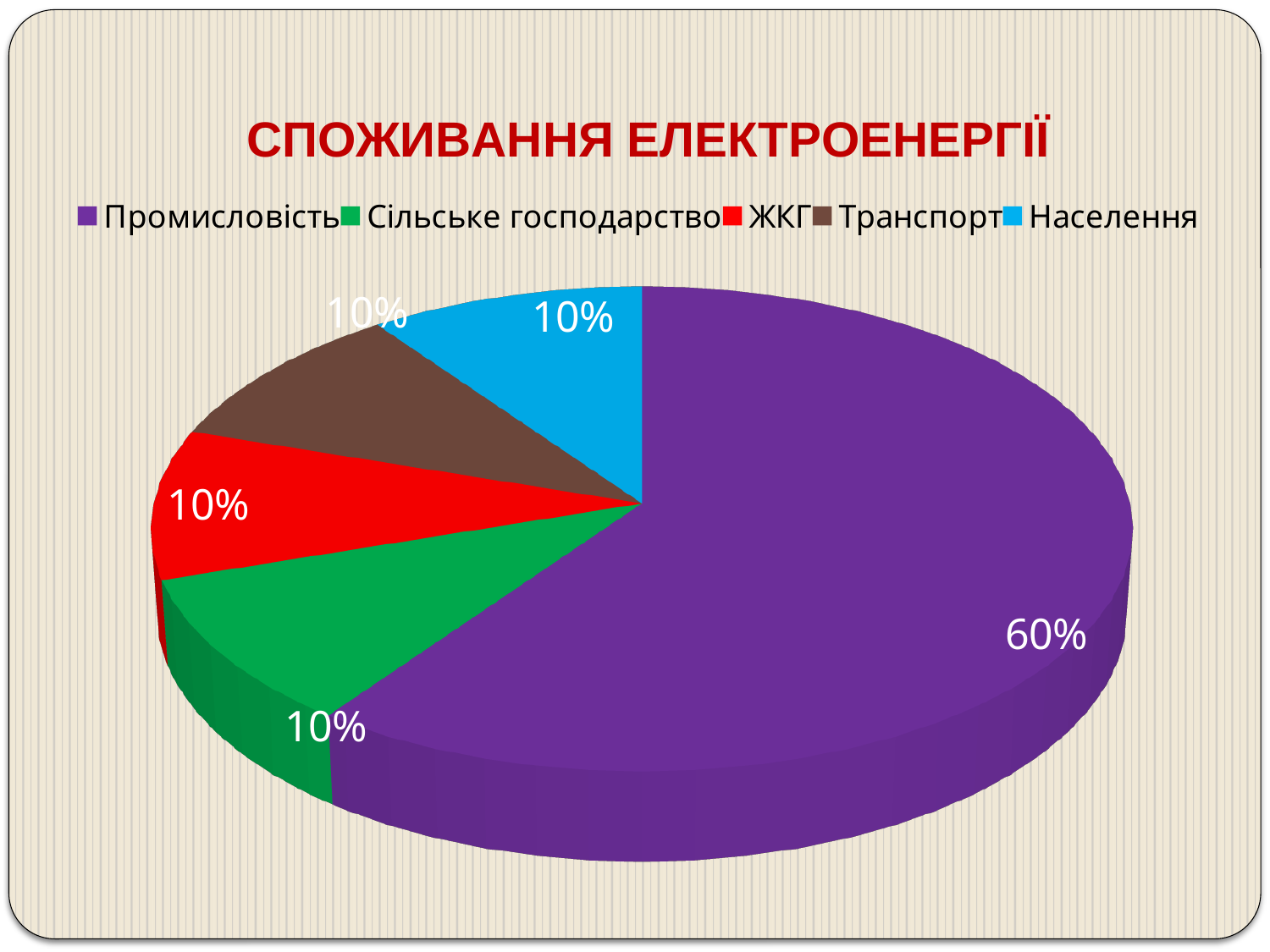
What colour is the slice for Населення? blue Which category has the largest slice of the pie? Промисловість What share of the pie does Населення have? 10% What is the difference between the shares of Промисловість and Транспорт? 50% How many categories does the legend list? 5 What share of the pie does Сільське господарство have? 10% What share of the pie does Транспорт have? 10% What share of the pie does ЖКГ have? 10% What is the title of the chart? СПОЖИВАННЯ ЕЛЕКТРОЕНЕРГІЇ Which is larger, the share of Промисловість or the share of Населення? Промисловість What share of the pie does Промисловість have? 60% What kind of chart is shown on the slide? pie chart